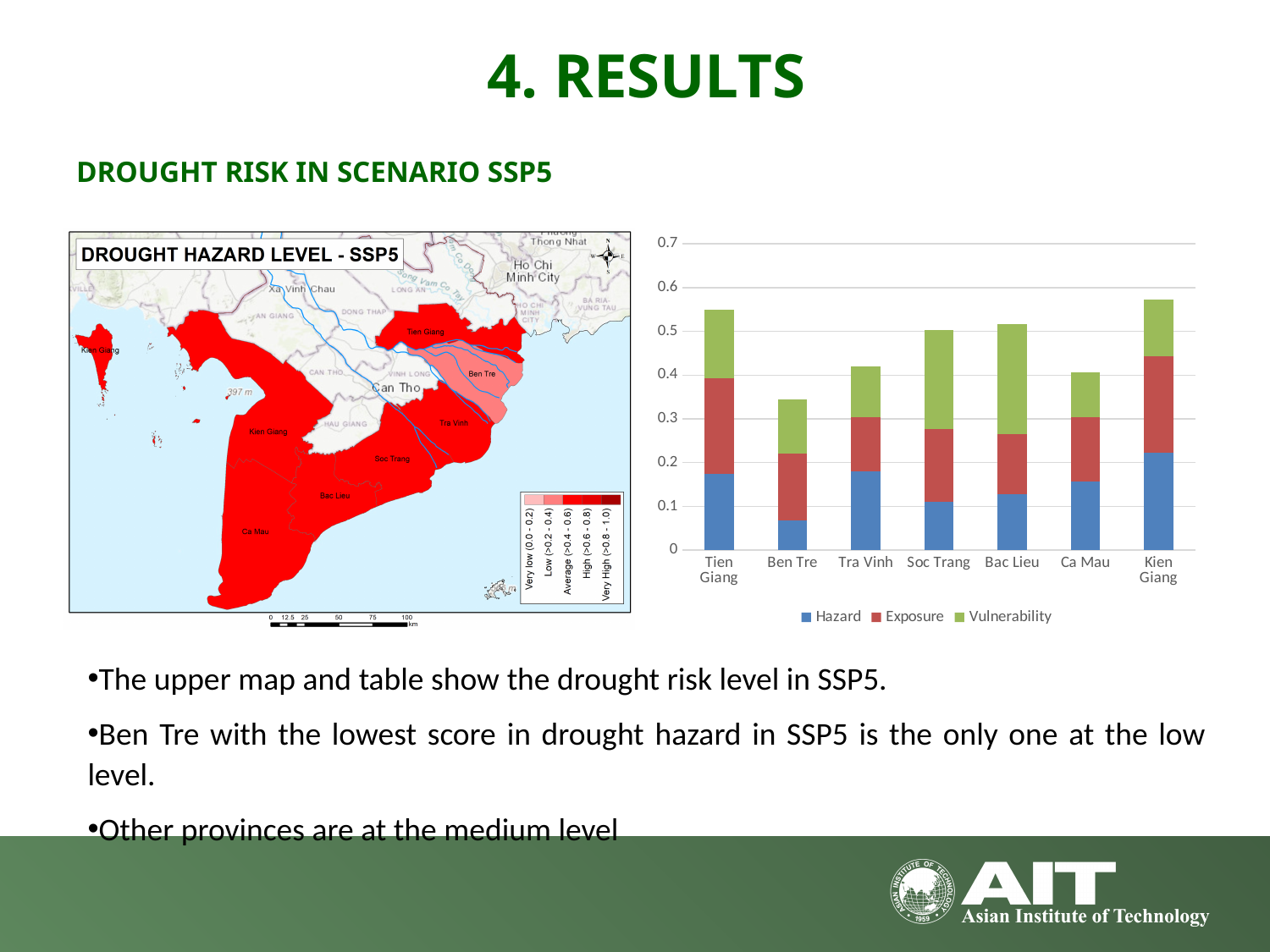
Is the total stacked value for Ca Mau greater or less than 0.5? less Which series is shown in green in the bar chart? Vulnerability Which province has the highest Hazard value in the chart? Kien Giang Which province has the lowest total stacked bar in the chart? Ben Tre Which province has the lowest Hazard value in the chart? Ben Tre What kind of chart is shown on the right of the slide? Stacked bar chart Is the total stacked value for Kien Giang greater or less than 0.5? greater Is the total stacked value for Ben Tre greater or less than 0.4? less How many provinces are shown on the x axis of the bar chart? 7 How many series does the legend of the bar chart list? 3 Which has a larger total stacked bar, Tien Giang or Ben Tre? Tien Giang Which series forms the bottom segment of each stacked bar? Hazard